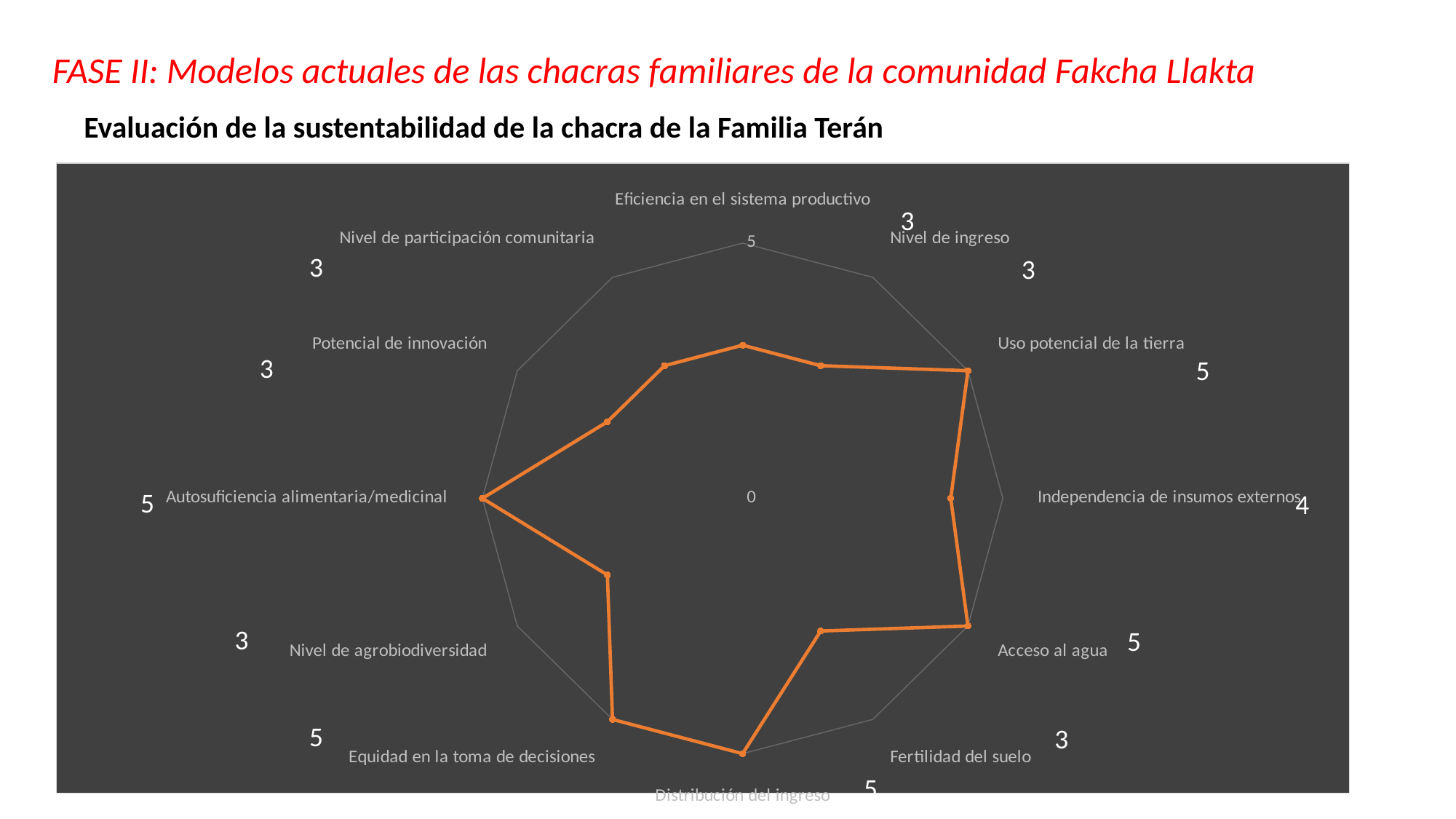
Which is larger, the value for Uso potencial de la tierra or the value for Nivel de ingreso? Uso potencial de la tierra What is the value for Eficiencia en el sistema productivo? 3 What is the difference between the value for Autosuficiencia alimentaria/medicinal and the value for Potencial de innovación? 2 What is the maximum value shown on the chart's axis scale? 5 What is the title of the chart? Evaluación de la sustentabilidad de la chacra de la Familia Terán What is the value for Independencia de insumos externos? 4 What is the difference between the value for Acceso al agua and the value for Independencia de insumos externos? 1 What is the value for Uso potencial de la tierra? 5 How many categories (axes) does the radar chart have? 12 What kind of chart is shown on the slide? Radar chart What is the value for Acceso al agua? 5 What is the value for Nivel de agrobiodiversidad? 3